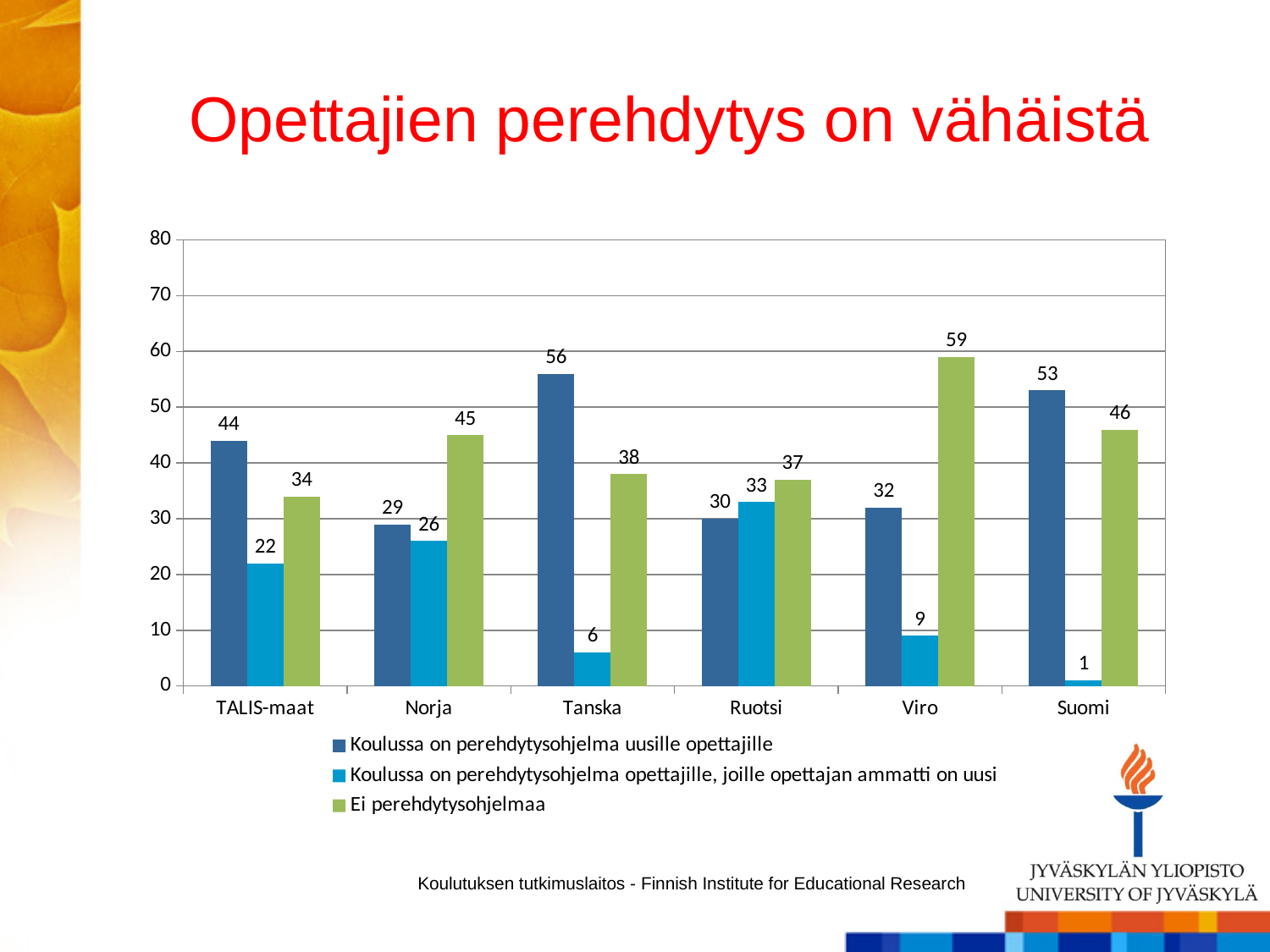
What kind of chart is shown on the slide? bar chart Which category has the lowest value in the series "Koulussa on perehdytysohjelma opettajille, joille opettajan ammatti on uusi"? Suomi Is the value for Norja in the series "Ei perehdytysohjelmaa" greater or less than 40? greater What is the value for Suomi in the series "Koulussa on perehdytysohjelma uusille opettajille"? 53 What is the value for Tanska in the series "Koulussa on perehdytysohjelma opettajille, joille opettajan ammatti on uusi"? 6 How many series does the legend list? 3 Which category has the highest value in the series "Koulussa on perehdytysohjelma uusille opettajille"? Tanska For Ruotsi, which is larger: the value for "Koulussa on perehdytysohjelma uusille opettajille" or the value for "Ei perehdytysohjelmaa"? Ei perehdytysohjelmaa What is the difference between the "Ei perehdytysohjelmaa" values for Viro and Suomi? 13 What is the value for Viro in the series "Ei perehdytysohjelmaa"? 59 What is the title of the slide? Opettajien perehdytys on vähäistä How many categories are shown on the x axis? 6